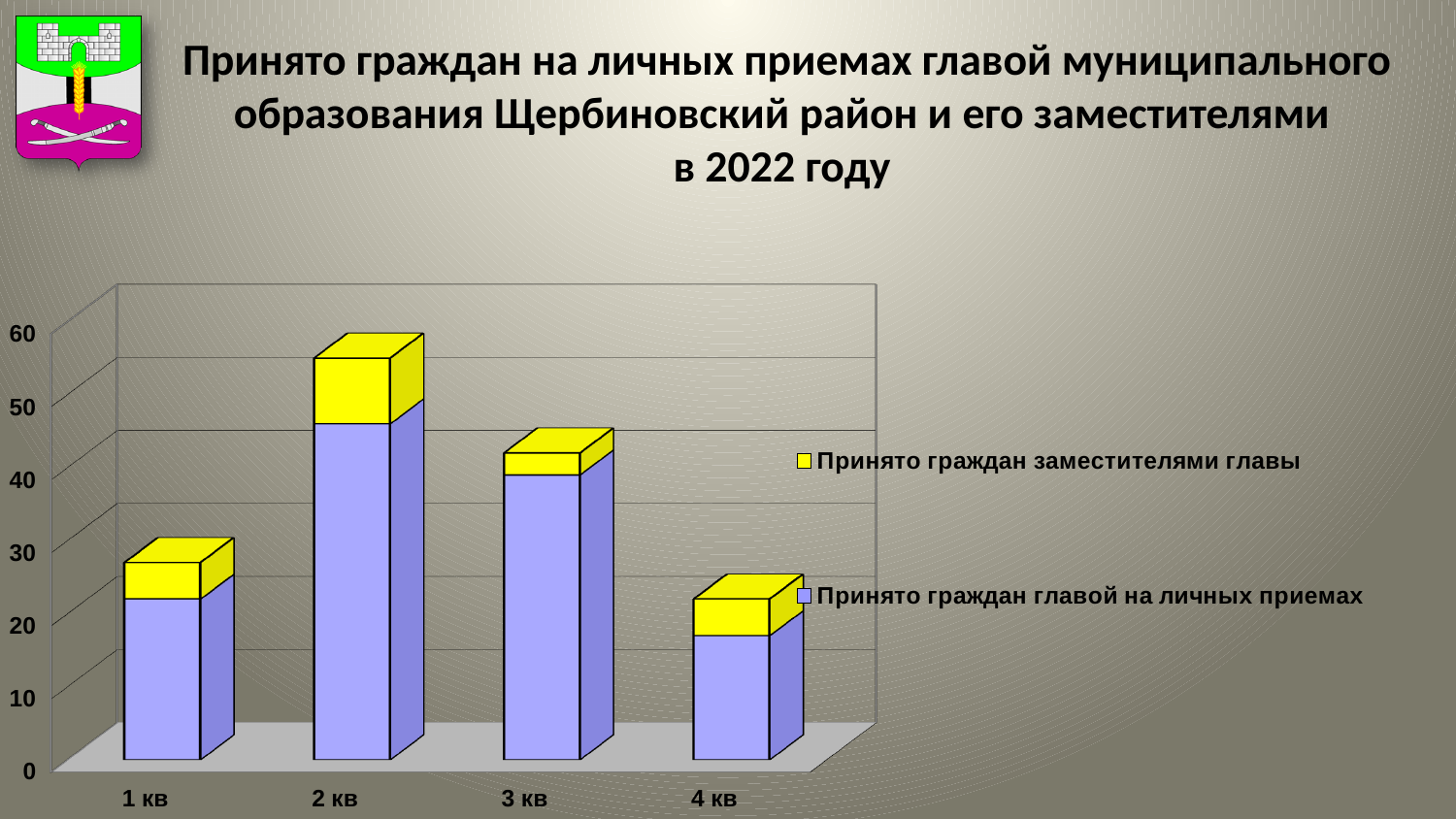
Is the total bar for 2 кв greater or less than 50? greater Is the total bar for 4 кв greater or less than 30? less What kind of chart is shown on the slide? Stacked bar chart Which quarter has the highest total bar? 2 кв Which total bar is larger, 1 кв or 3 кв? 3 кв Is the total bar for 1 кв greater or less than 40? less Which colour represents 'Принято граждан заместителями главы' in the legend? Yellow How many series does the legend list? 2 From 2 кв to 4 кв, do the total bars rise or fall? fall Which quarter has the lowest total bar? 4 кв How many quarters (categories) are shown on the x axis? 4